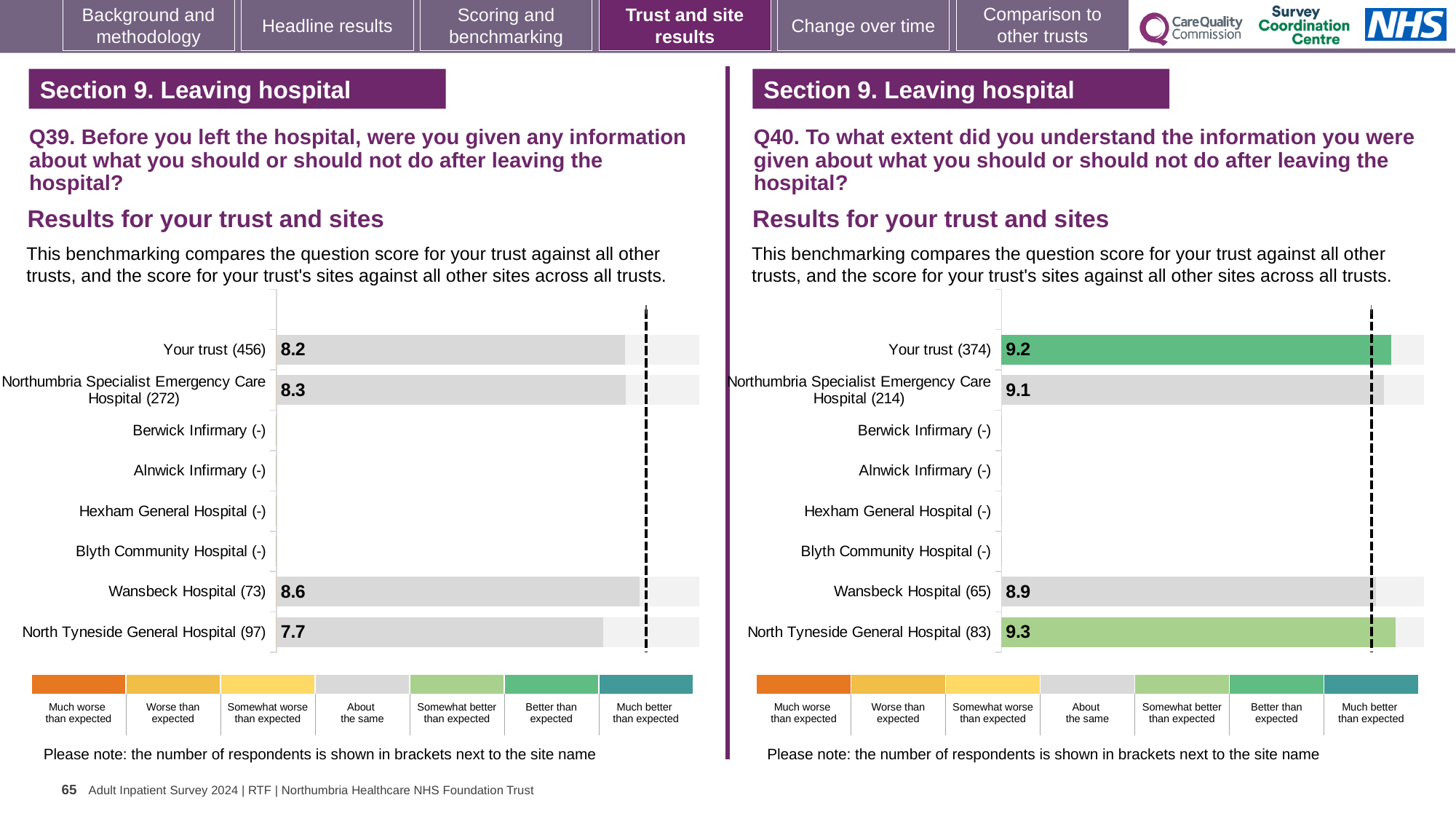
What kind of chart is used on the Q39 chart (left)? Bar chart On the Q40 chart (right), what is the score for Northumbria Specialist Emergency Care Hospital? 9.1 On the Q39 chart (left), which site or trust row has the lowest score? North Tyneside General Hospital On the Q40 chart (right), which is larger: the score for Your trust or the score for Wansbeck Hospital? Your trust On the Q40 chart (right), what is the score for Your trust? 9.2 On the Q40 chart (right), which site or trust row has the lowest score? Wansbeck Hospital On the Q39 chart (left), what is the score for North Tyneside General Hospital? 7.7 On the Q39 chart (left), which site or trust row has the highest score? Wansbeck Hospital On the Q40 chart (right), how many respondents are shown in brackets for Your trust? 374 On the Q40 chart (right), which site or trust row has the highest score? North Tyneside General Hospital On the Q39 chart (left), what is the score for Wansbeck Hospital? 8.6 On the Q39 chart (left), what is the difference between the Wansbeck Hospital score and the North Tyneside General Hospital score? 0.9